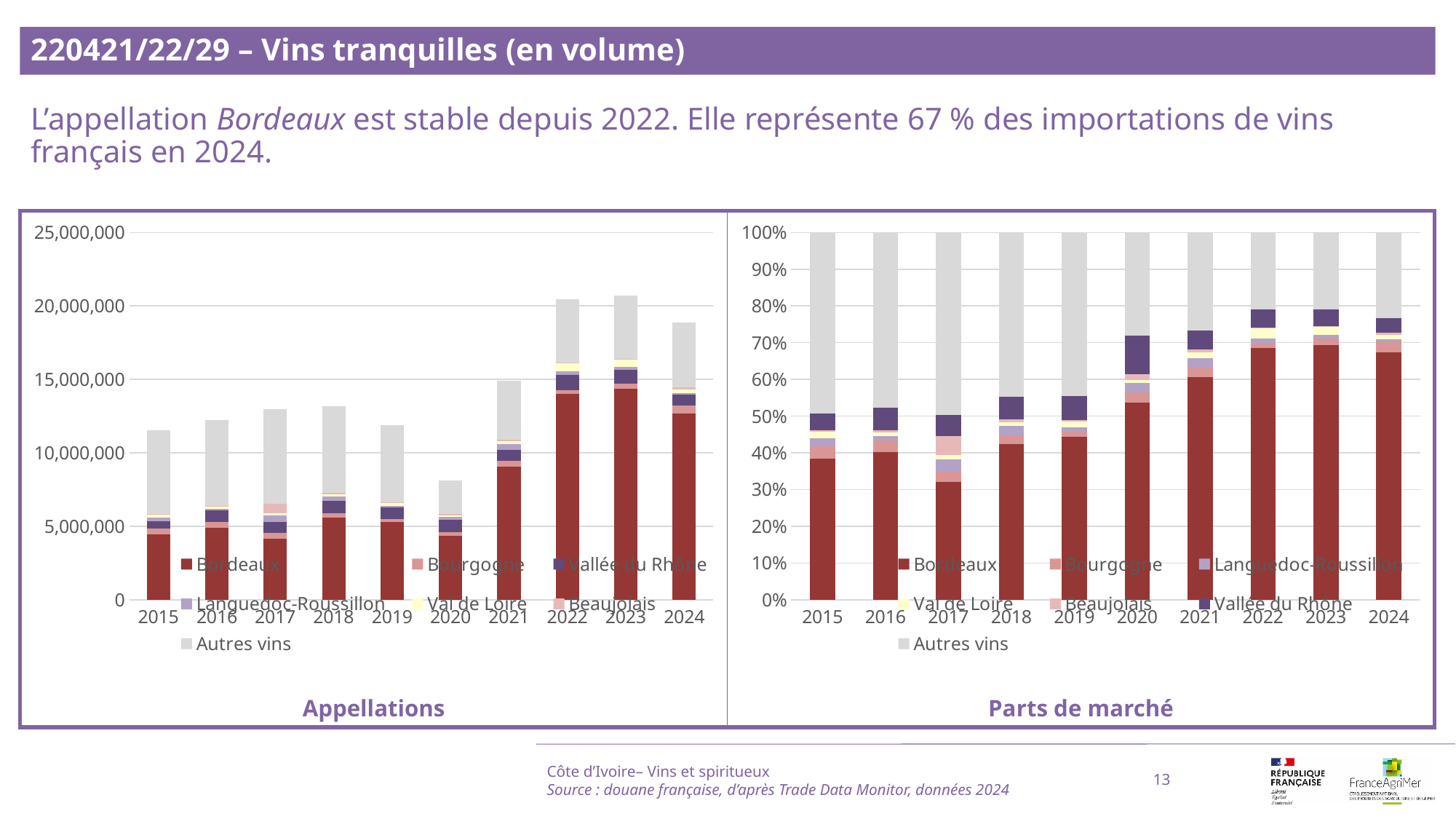
How many years are shown on the x axis of the "Parts de marché" chart? 10 In the "Appellations" chart, which year has the lowest total bar? 2020 In the "Appellations" chart, is the total bar for 2020 greater or less than 10,000,000? less In the "Parts de marché" chart, does the Bordeaux share generally rise or fall from 2015 to 2024? rise In the "Parts de marché" chart, which colour represents "Autres vins"? grey How many series does the legend of the "Appellations" chart list? 7 In the "Appellations" chart, which total bar is larger, 2019 or 2021? 2021 In the "Appellations" chart, is the total bar for 2023 greater or less than 20,000,000? greater What kind of chart is the "Appellations" chart on the left? stacked bar chart In the "Appellations" chart, is the total bar for 2018 greater or less than 15,000,000? less